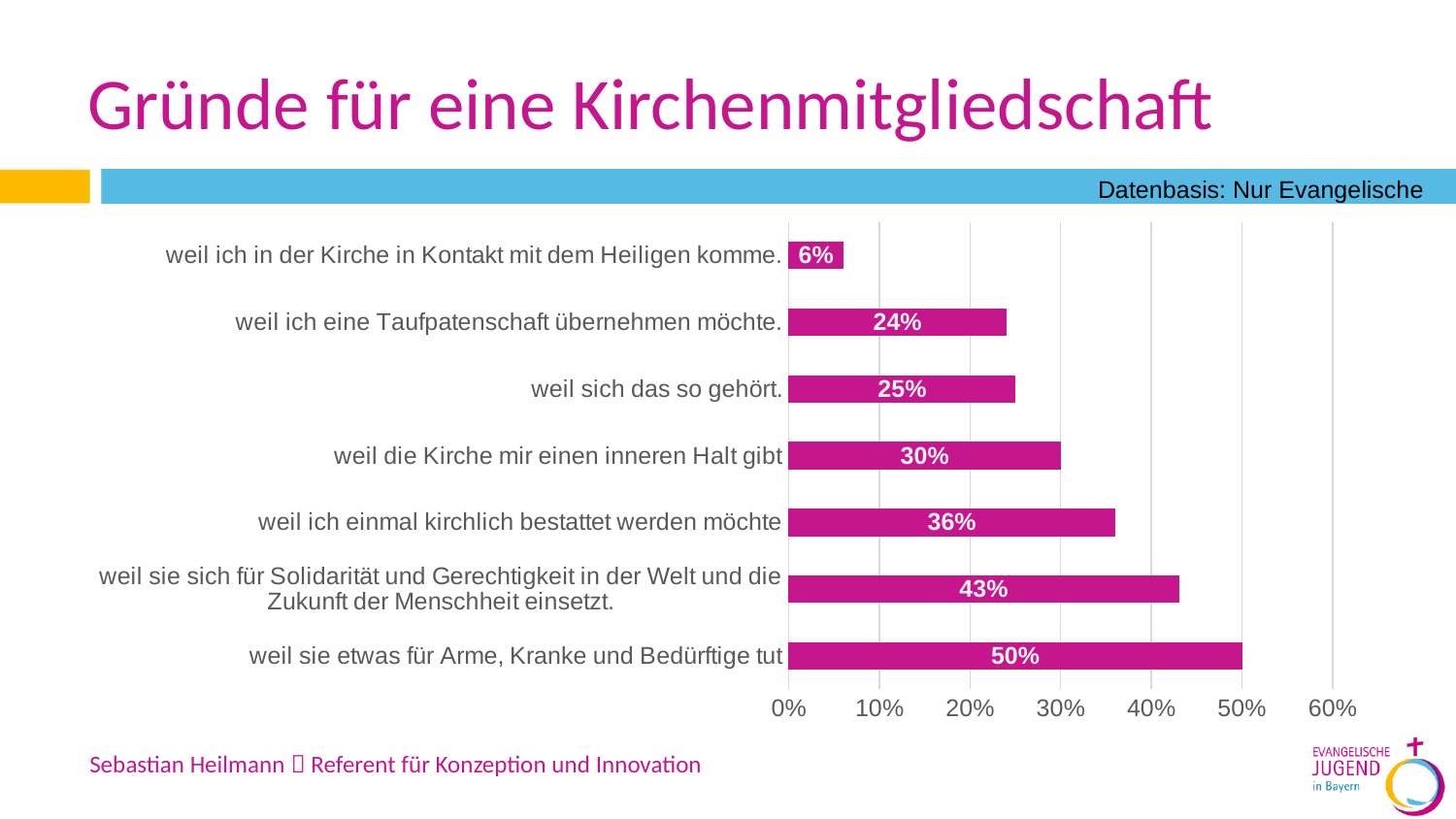
What is the value for "weil die Kirche mir einen inneren Halt gibt"? 30% What is the value for "weil ich eine Taufpatenschaft übernehmen möchte."? 24% How many categories are shown in the chart? 7 What is the value for "weil sie etwas für Arme, Kranke und Bedürftige tut"? 50% What is the title of the slide? Gründe für eine Kirchenmitgliedschaft Which is larger: the value for "weil sich das so gehört." or the value for "weil ich eine Taufpatenschaft übernehmen möchte."? weil sich das so gehört. What kind of chart is shown on the slide? bar chart What is the difference between the values for "weil sie etwas für Arme, Kranke und Bedürftige tut" and "weil ich einmal kirchlich bestattet werden möchte"? 14% Which category has the highest value? weil sie etwas für Arme, Kranke und Bedürftige tut Which category has the lowest value? weil ich in der Kirche in Kontakt mit dem Heiligen komme. Is the value for "weil sie sich für Solidarität und Gerechtigkeit in der Welt und die Zukunft der Menschheit einsetzt." greater or less than 40%? greater What data basis is stated on the slide? Nur Evangelische